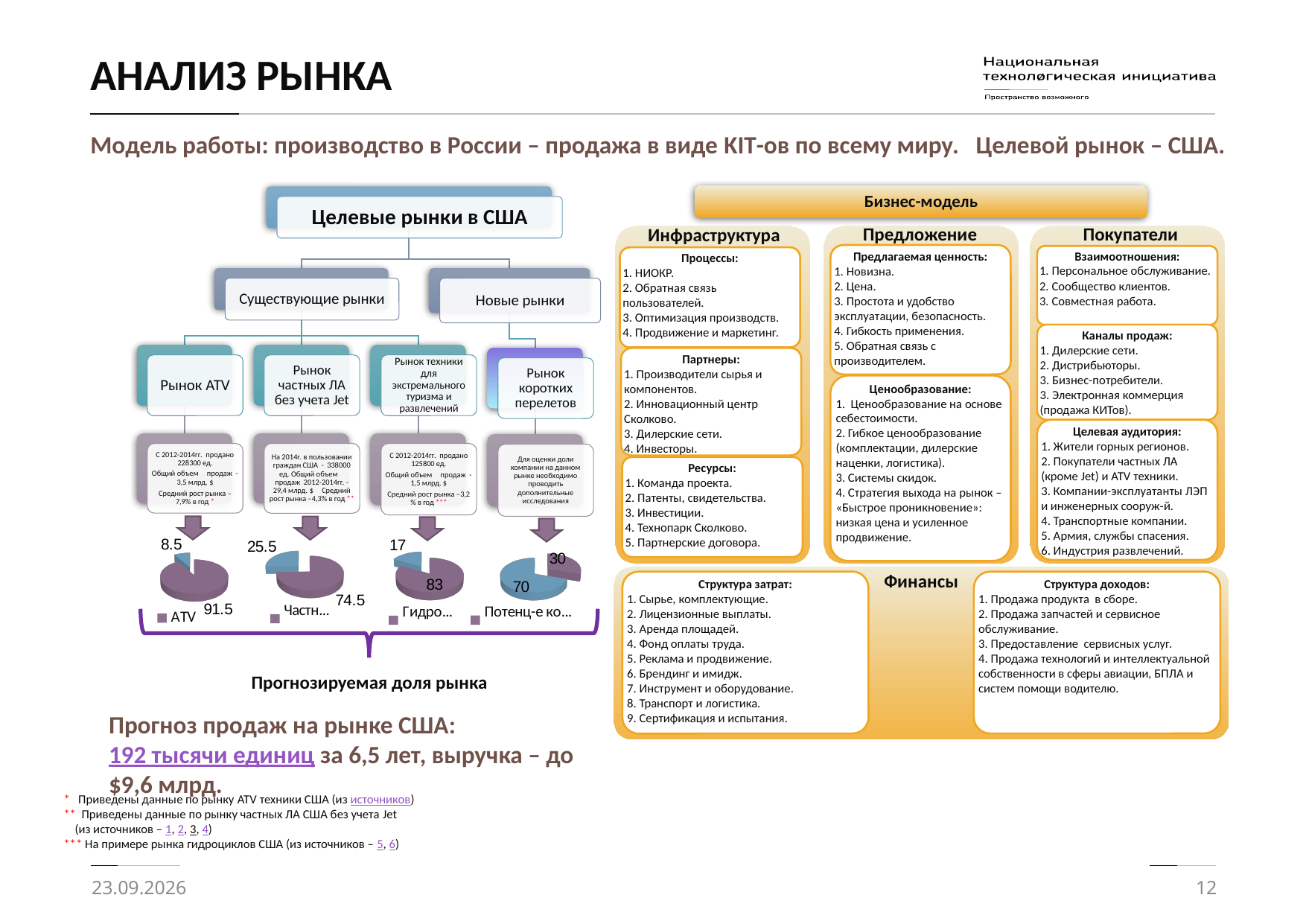
In the leftmost pie chart (ATV), what is the value of the larger slice? 91.5 Which of the four pie charts has the largest smaller slice? Потенц-е ко... In the second pie chart (Частн...), what is the value of the smaller slice? 25.5 In the leftmost pie chart (ATV), what is the value of the smaller slice? 8.5 In the third pie chart (Гидро...), what is the value of the larger slice? 83 In the second pie chart (Частн...), what is the difference between the larger slice (74.5) and the smaller slice (25.5)? 49 In the rightmost pie chart (Потенц-е ко...), what is the value of the smaller slice? 30 In the third pie chart (Гидро...), what is the difference between the larger slice (83) and the smaller slice (17)? 66 How many slices does each of the four pie charts have? 2 What kind of chart is used to show the forecast market share for the ATV market (leftmost chart)? pie chart Which of the four pie charts has the smallest smaller slice? ATV How many pie charts are shown under the 'Целевые рынки в США' diagram? 4